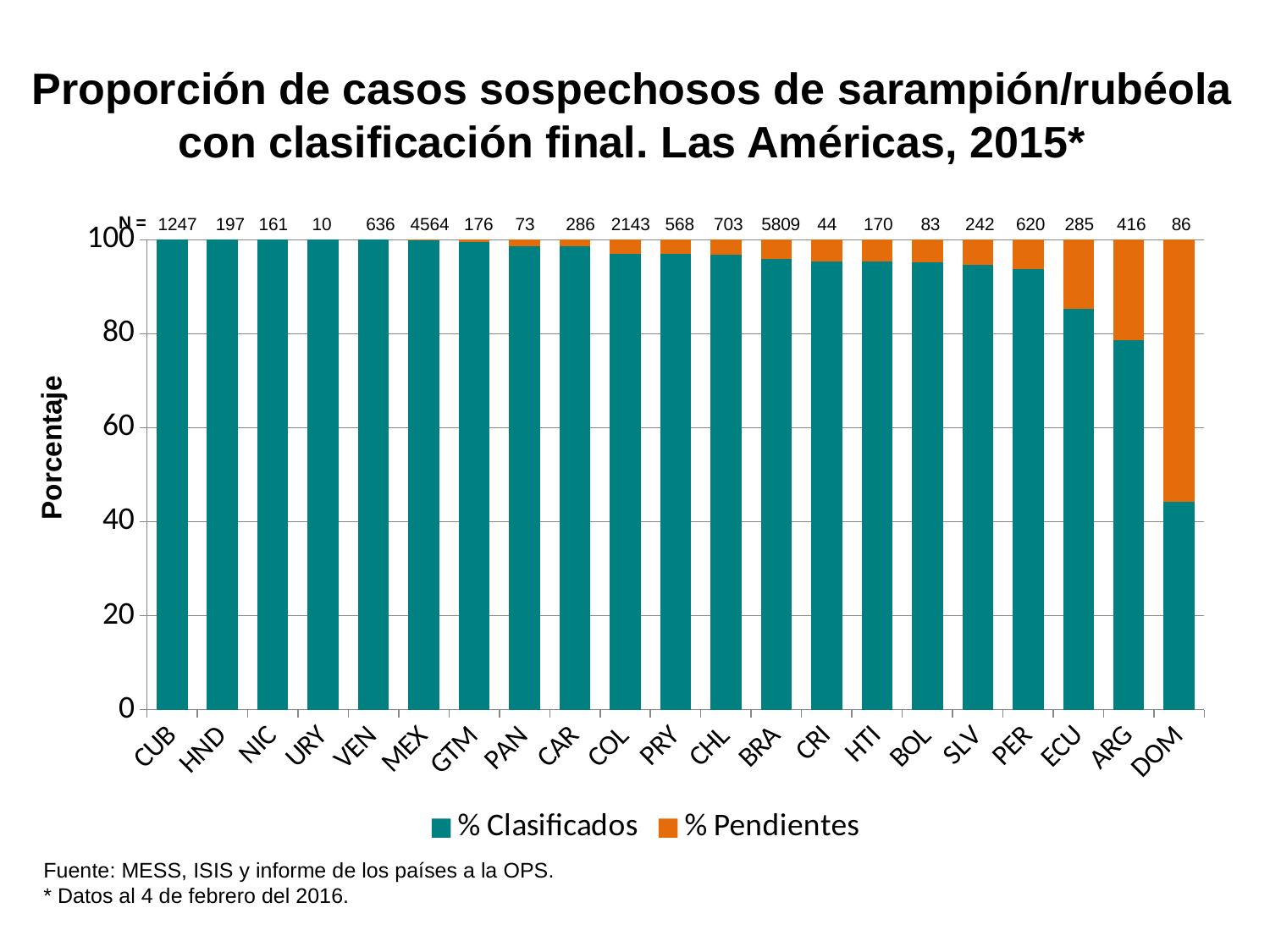
Do the % Clasificados values rise or fall moving from left to right along the x axis? fall How many countries are shown on the x axis? 21 Which country has the lowest N value printed above its bar? URY How many series does the legend list? 2 What is the difference between the N values for BRA and MEX? 1245 Which country has the highest N value printed above its bar? BRA What is the label on the y axis? Porcentaje Which country has a larger % Pendientes share, DOM or ARG? DOM What kind of chart is shown on the slide? Stacked bar chart What is the N value printed above the bar for MEX? 4564 Is the % Clasificados value for DOM greater or less than 60? less What is the N value printed above the bar for DOM? 86